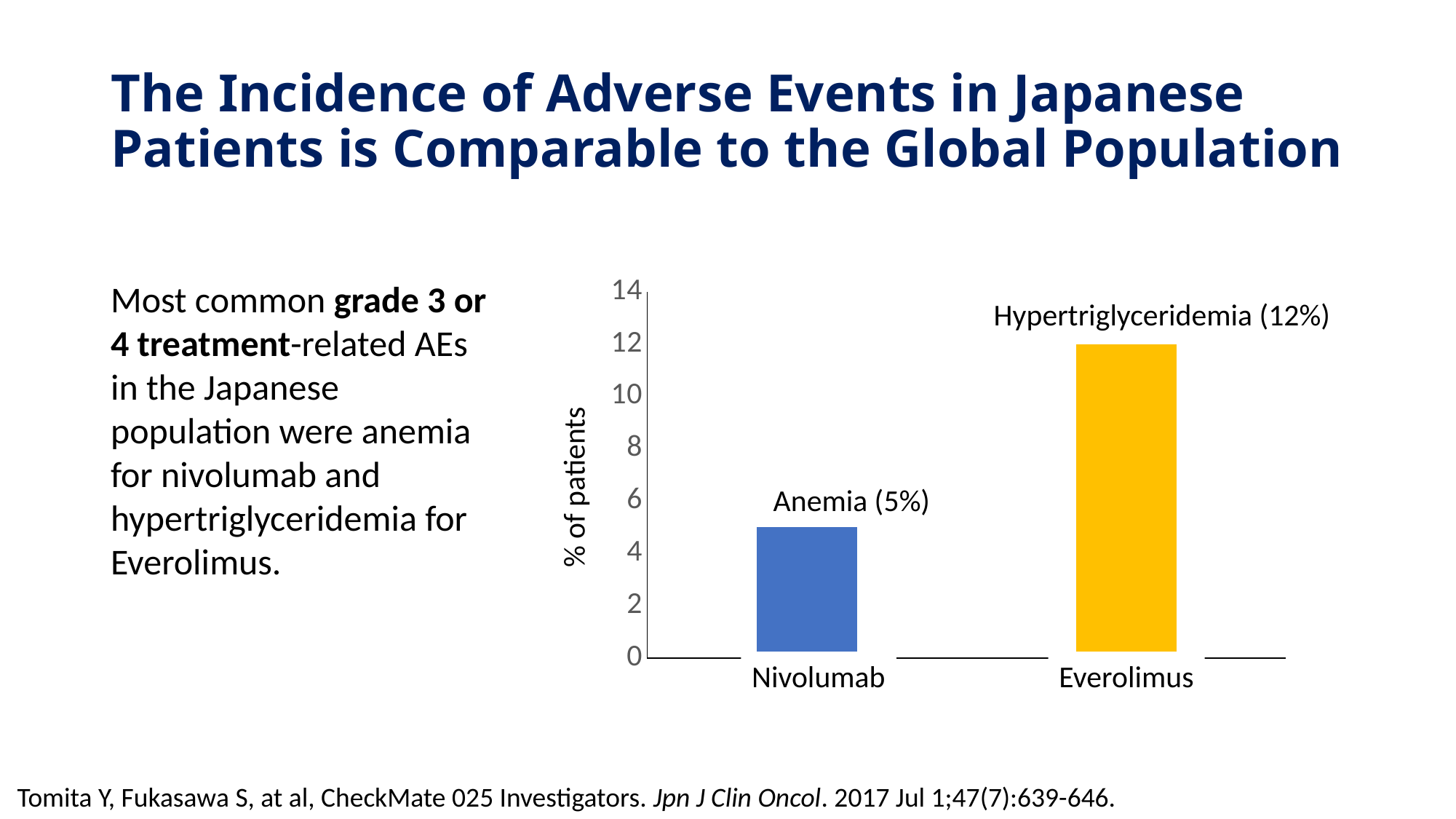
Which is larger, the value for Nivolumab or the value for Everolimus? Everolimus What is the value for Everolimus? 12% What is the value for Nivolumab? 5% Is the value for Everolimus greater or less than 10? greater What is the difference between the values for Everolimus and Nivolumab? 7% Is the value for Nivolumab greater or less than 6? less Which adverse event is labelled on the Nivolumab bar? Anemia Which category has the highest value? Everolimus How many categories are shown on the x axis? 2 Which category has the lowest value? Nivolumab What kind of chart is shown on the slide? Bar chart What is the label of the y axis? % of patients